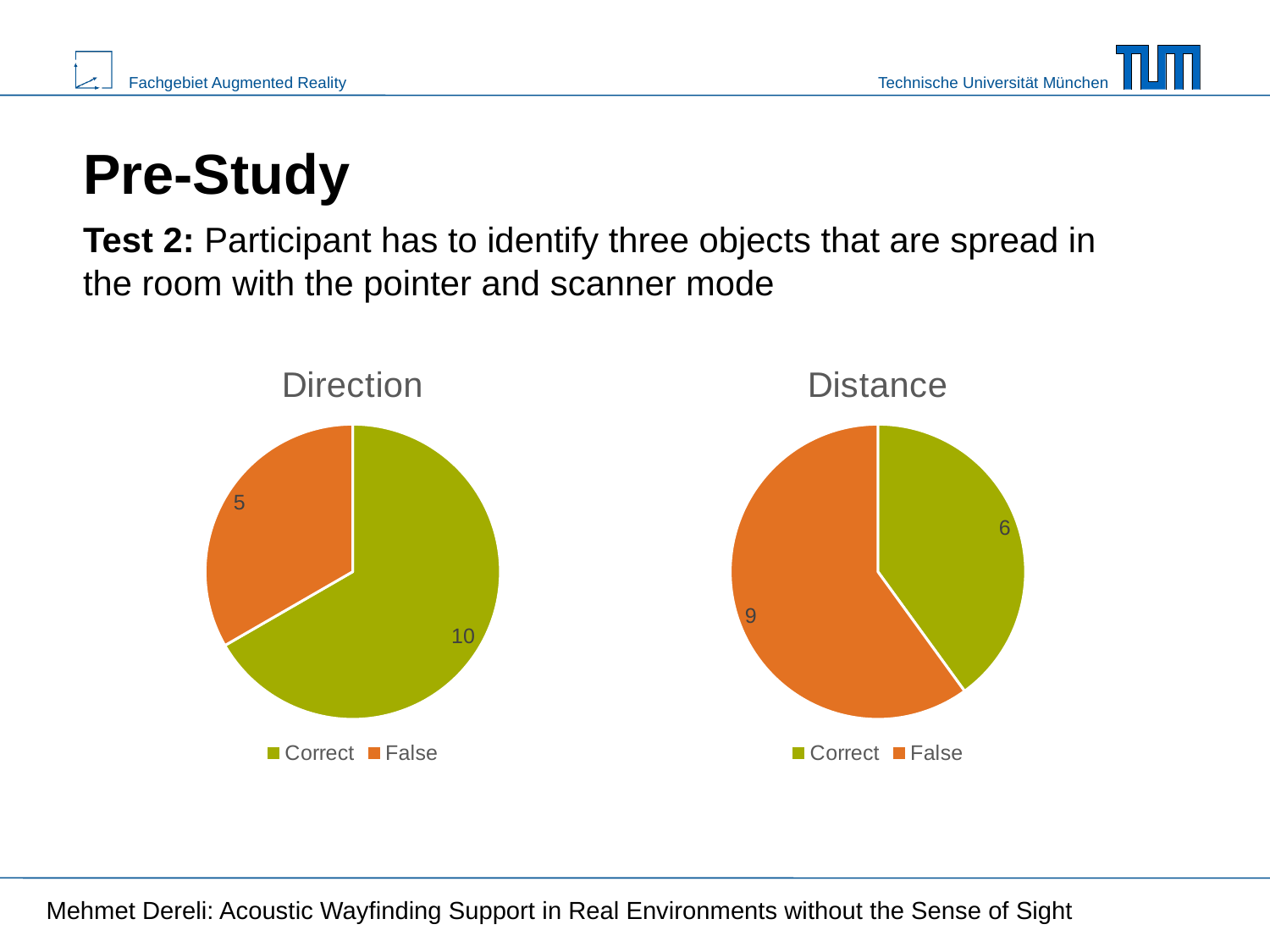
In the Direction chart, how many responses were Correct? 10 In the Distance chart, how many responses were Correct? 6 In the Distance chart, what share of the total does the False slice represent? 60% In the Direction chart, which slice is larger, Correct or False? Correct In the Distance chart, how many responses were False? 9 In the Distance chart, which slice is the largest? False What type of chart is the Direction chart? Pie chart What colour represents Correct in the legend of the Direction chart? Green In the Direction chart, what is the difference between the Correct and False counts? 5 In the Direction chart, how many responses were False? 5 In the Distance chart, what is the difference between the False and Correct counts? 3 How many slices does the Distance chart have? 2